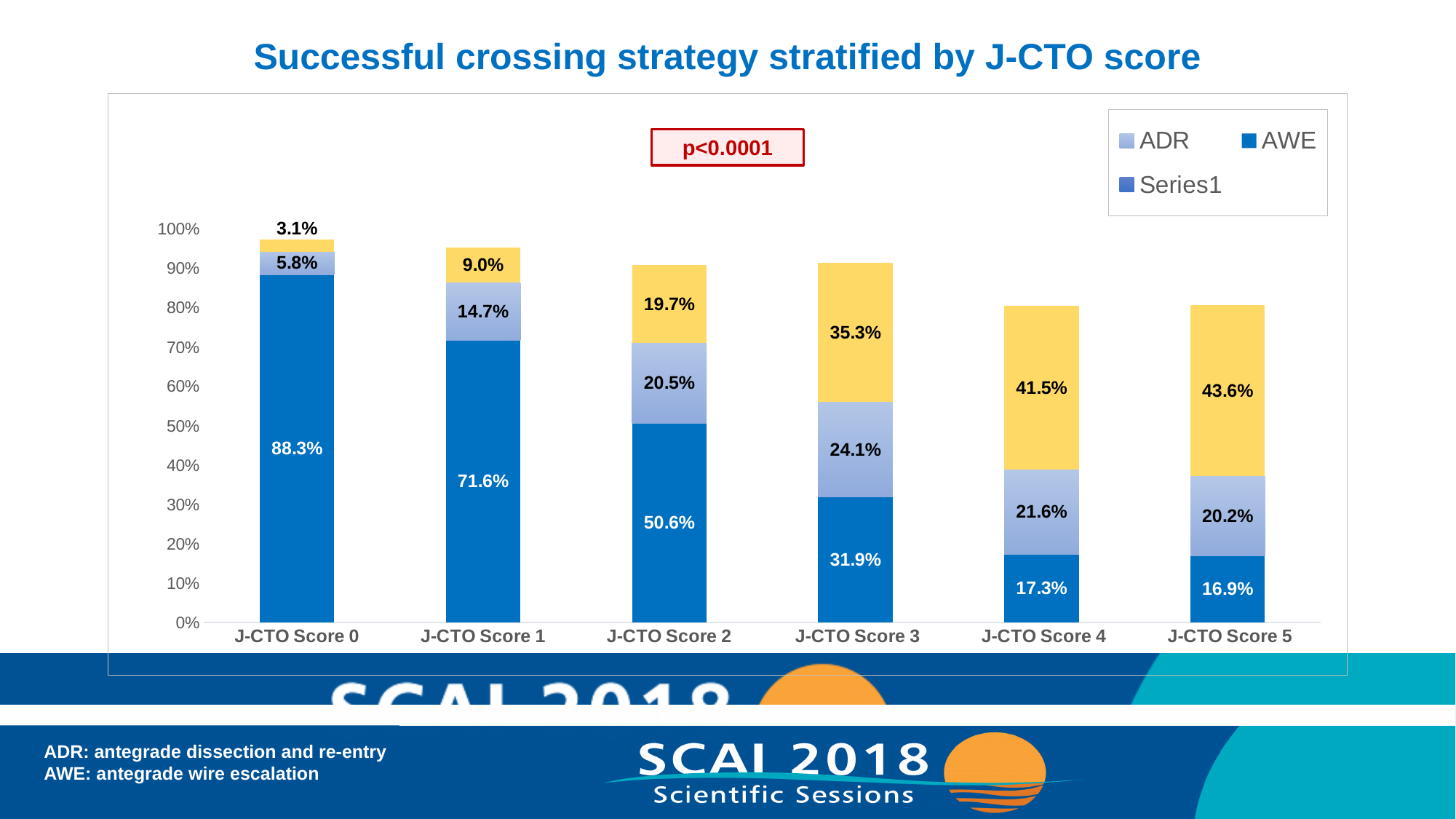
What is the ADR value for J-CTO Score 5? 20.2% What kind of chart is shown on the slide? Stacked bar chart What is the difference between the AWE values for J-CTO Score 0 and J-CTO Score 1? 16.7 percentage points What is the AWE value for J-CTO Score 0? 88.3% How many series does the legend list? 3 Which J-CTO score category has the lowest AWE value? J-CTO Score 5 What is the ADR value for J-CTO Score 2? 20.5% What is the AWE value for J-CTO Score 3? 31.9% Which is larger, the ADR value for J-CTO Score 3 or for J-CTO Score 4? J-CTO Score 3 How many J-CTO score categories are shown on the x axis? 6 Does the AWE value rise or fall as the J-CTO score increases from 0 to 5? Falls Which J-CTO score category has the highest AWE value? J-CTO Score 0